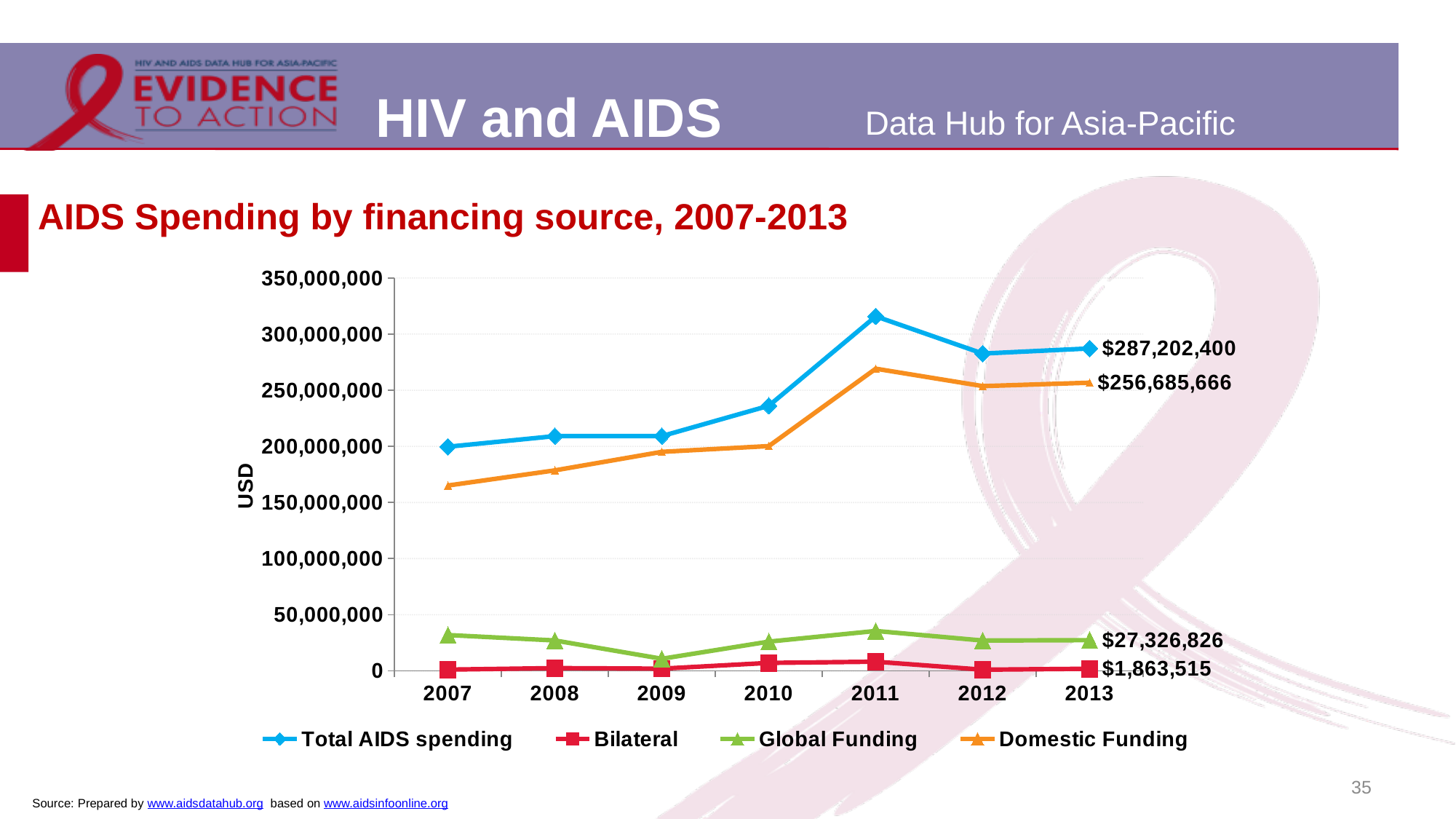
In which year is Global Funding lowest? 2009 Is the value for Total AIDS spending in 2011 greater or less than 300,000,000? greater What is the data label for Bilateral in 2013? $1,863,515 What is the data label for Global Funding in 2013? $27,326,826 How many years are shown on the x axis? 7 In which year is Total AIDS spending highest? 2011 Which is larger in 2013, Domestic Funding or Global Funding? Domestic Funding How many series does the legend list? 4 What is the data label for Domestic Funding in 2013? $256,685,666 What is the difference between Total AIDS spending and Domestic Funding in 2013? $30,516,734 What kind of chart is shown on the slide? line chart What is the data label for Total AIDS spending in 2013? $287,202,400